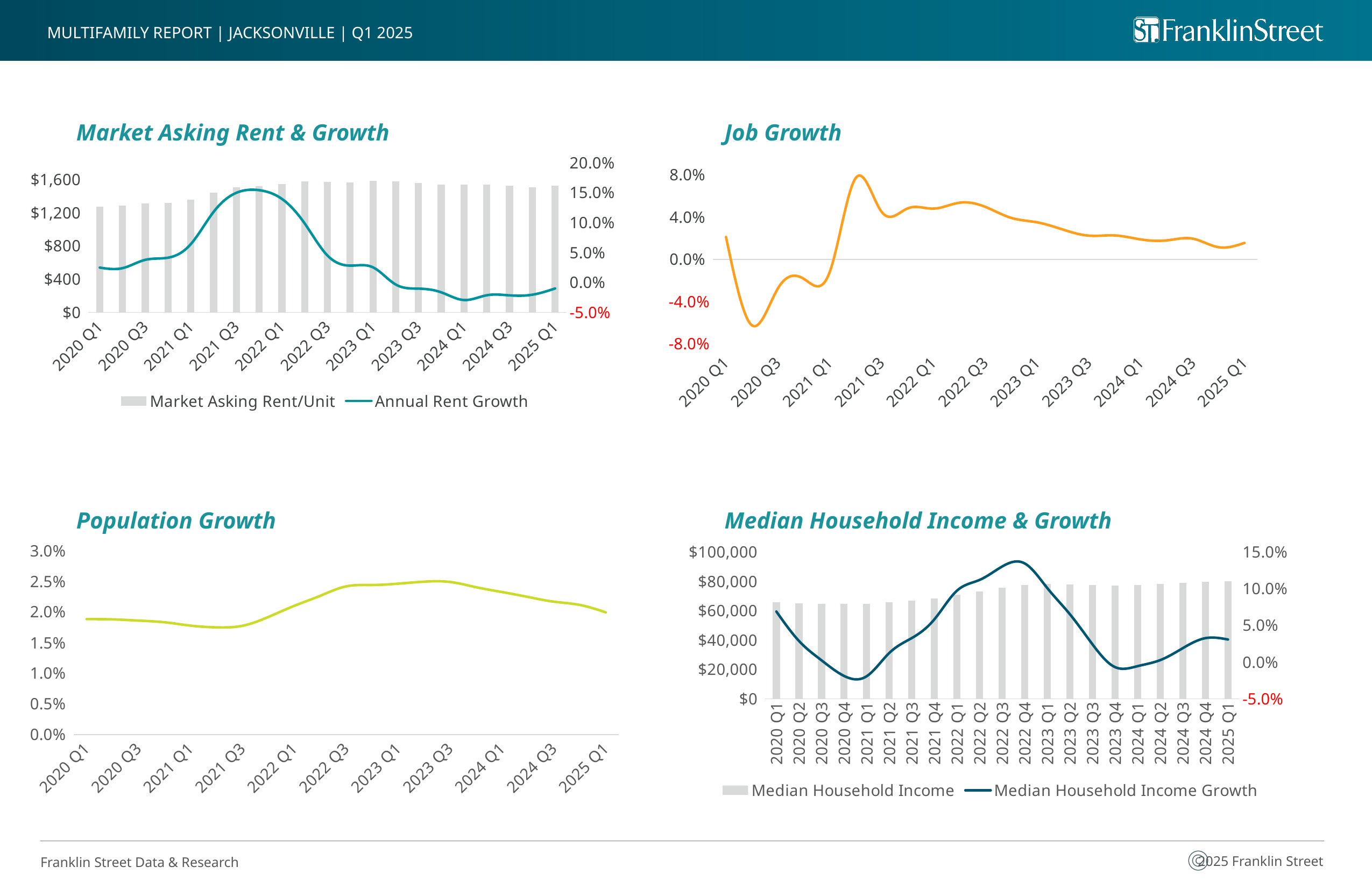
In the Job Growth chart, which quarter has the highest job growth? 2021 Q2 In the Market Asking Rent & Growth chart, is the Annual Rent Growth value for 2022 Q1 greater or less than 10.0%? greater In the Job Growth chart, which quarter has the lowest job growth? 2020 Q2 How many series does the legend of the Median Household Income & Growth chart list? 2 In the Population Growth chart, is the value for 2023 Q3 greater or less than 2.0%? greater In the Job Growth chart, does job growth generally rise or fall from 2022 Q3 to 2025 Q1? fall In the Median Household Income & Growth chart, is the Median Household Income Growth value for 2022 Q4 greater or less than 10.0%? greater How many series does the legend of the Market Asking Rent & Growth chart list? 2 What kind of chart is the Job Growth chart? line chart